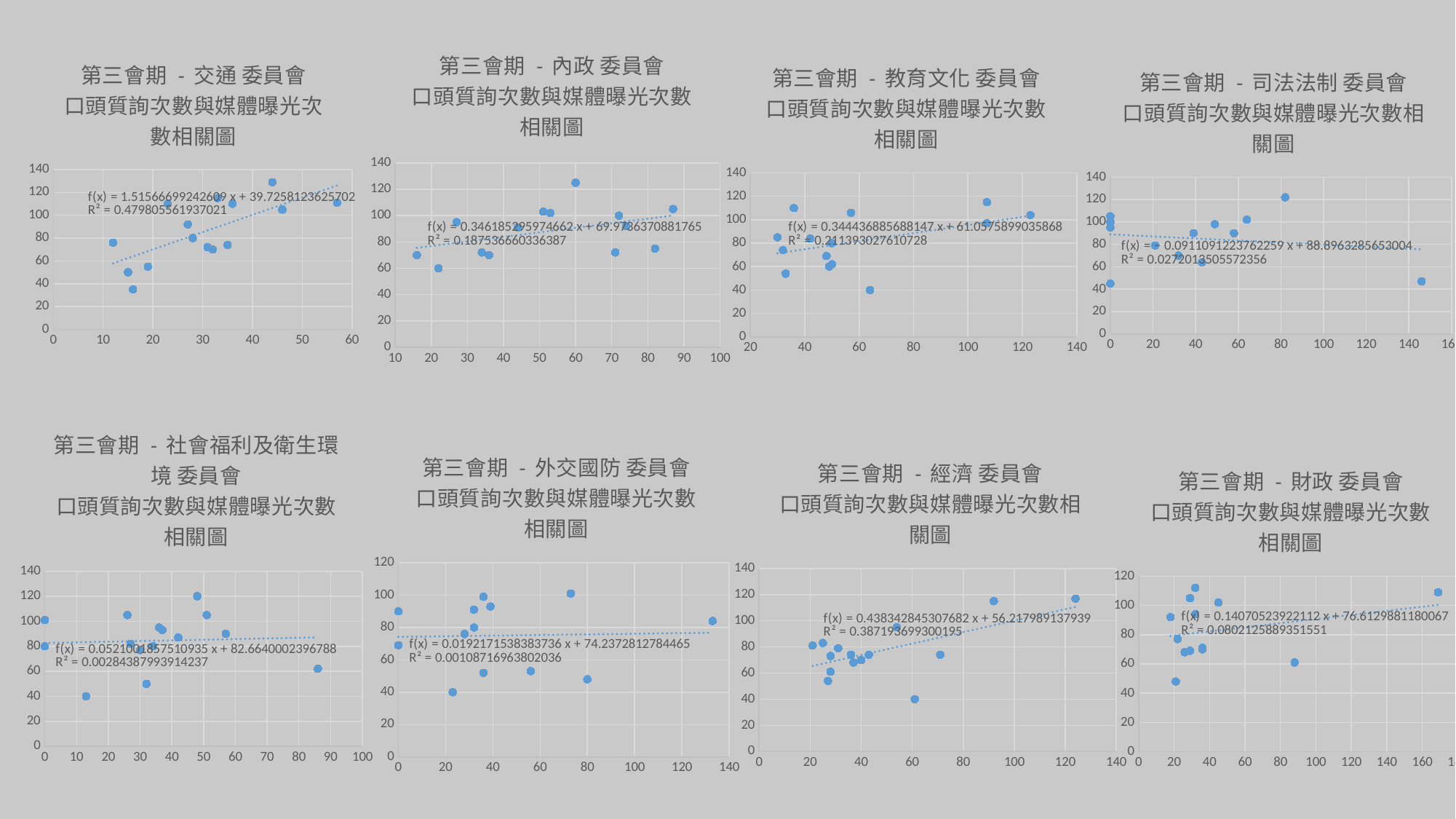
In the 第三會期 - 經濟 委員會 chart, does the trendline rise or fall as x increases? rise What is the R² value printed on the 第三會期 - 交通 委員會 chart? 0.479805561937021 In the 第三會期 - 交通 委員會 chart, does the trendline rise or fall as x increases? rise What kind of chart is used for the 第三會期 - 交通 委員會 chart? scatter chart How many charts are shown on the slide? 8 Which chart has the steeper trendline slope, 第三會期 - 交通 委員會 or 第三會期 - 經濟 委員會? 第三會期 - 交通 委員會 In the 第三會期 - 教育文化 委員會 chart, is the y value of the lowest point greater or less than 60? less In the 第三會期 - 經濟 委員會 chart, is the y value of the rightmost point greater or less than 100? greater Which chart has the larger R² value, 第三會期 - 交通 委員會 or 第三會期 - 經濟 委員會? 第三會期 - 交通 委員會 In the 第三會期 - 司法法制 委員會 chart, does the trendline rise or fall as x increases? fall In the 第三會期 - 交通 委員會 chart, is the y value of the highest point greater or less than 120? greater What is the maximum value shown on the y axis of the 第三會期 - 外交國防 委員會 chart? 120